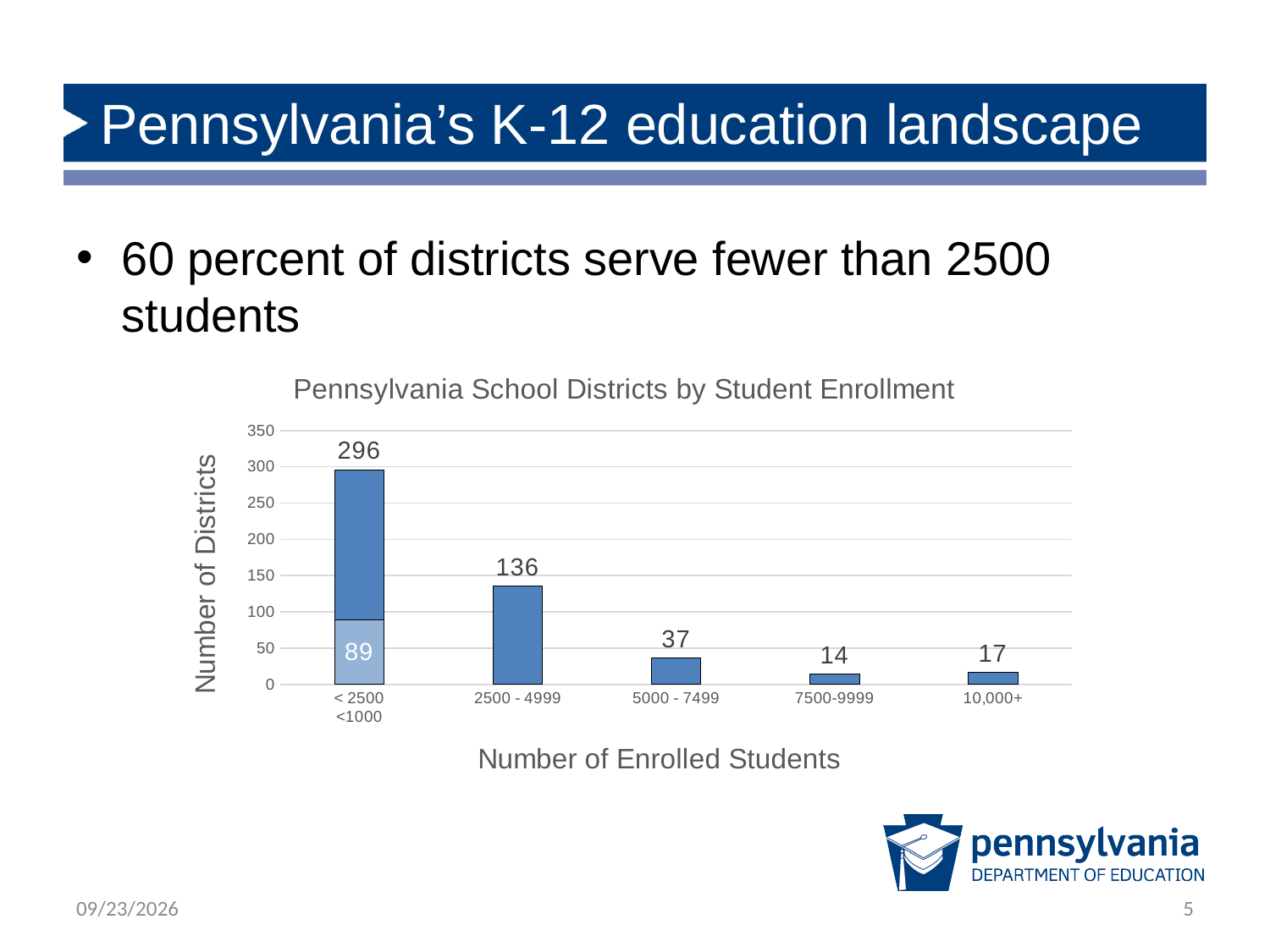
How many districts have 2500 - 4999 enrolled students? 136 What is the label of the y axis? Number of Districts How many districts have fewer than 1000 enrolled students? 89 Which enrollment category has the lowest number of districts? 7500-9999 What kind of chart is shown on the slide? bar chart How many districts have fewer than 2500 enrolled students? 296 What is the title of the chart? Pennsylvania School Districts by Student Enrollment How many enrollment categories are shown on the x axis? 5 How many districts have 10,000+ enrolled students? 17 Which enrollment category has the highest number of districts? < 2500 What is the difference between the number of districts with < 2500 students and the number with 2500 - 4999 students? 160 Which has more districts: 5000 - 7499 or 10,000+? 5000 - 7499